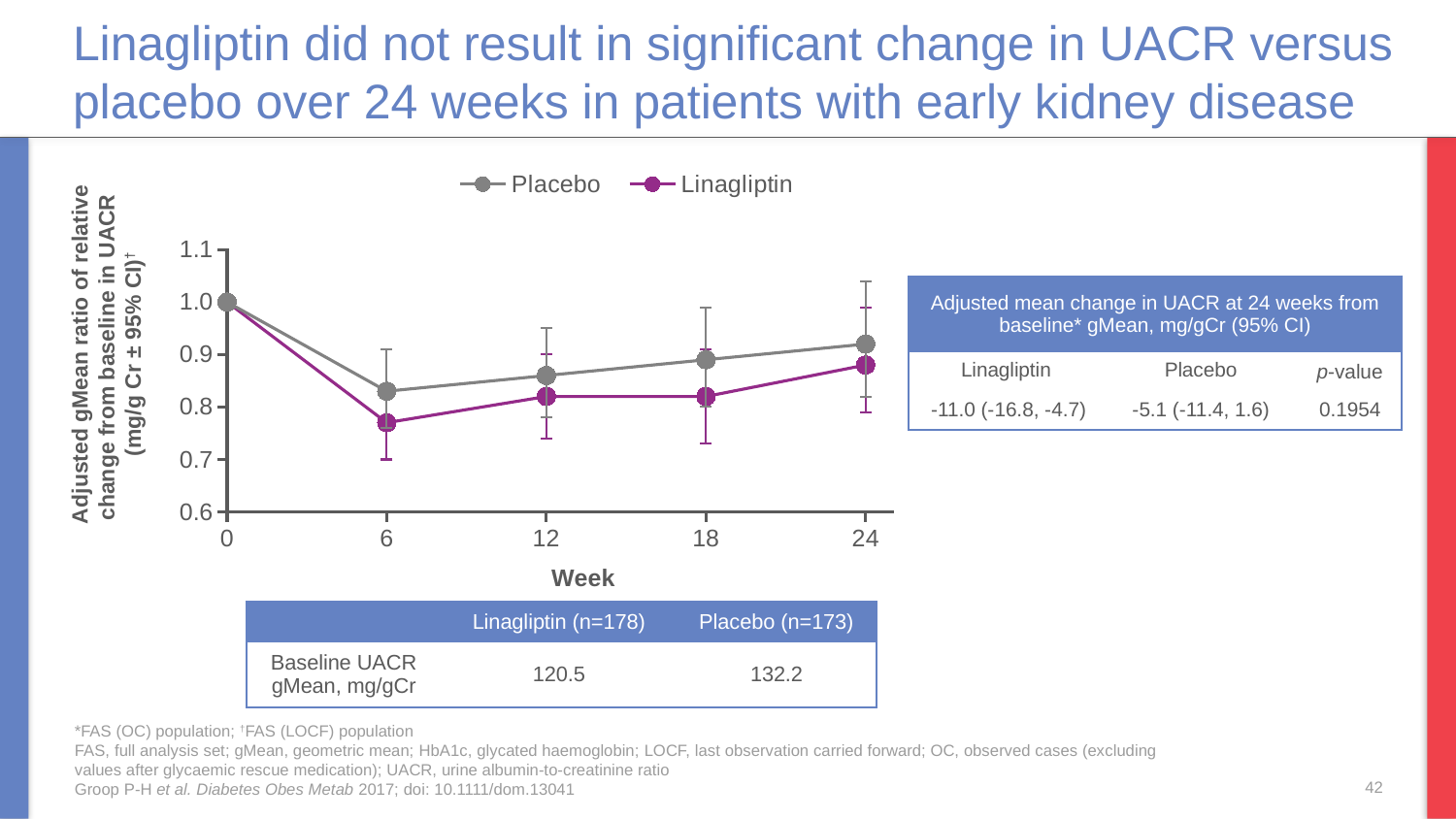
Is the value for Linagliptin at week 24 greater or less than 0.9? less Is the value for Placebo at week 6 greater or less than 0.8? greater Is the value for Linagliptin at week 6 greater or less than 0.8? less From week 6 to week 24, do the Linagliptin values rise or fall? rise What is the adjusted gMean ratio for Placebo at week 0? 1.0 What is the adjusted gMean ratio for Linagliptin at week 0? 1.0 At week 6, which series has the higher value, Placebo or Linagliptin? Placebo How many series does the chart legend list? 2 How many time points (weeks) are plotted for each series? 5 What kind of chart is shown on the slide? line chart At which week does the Linagliptin series reach its lowest value? 6